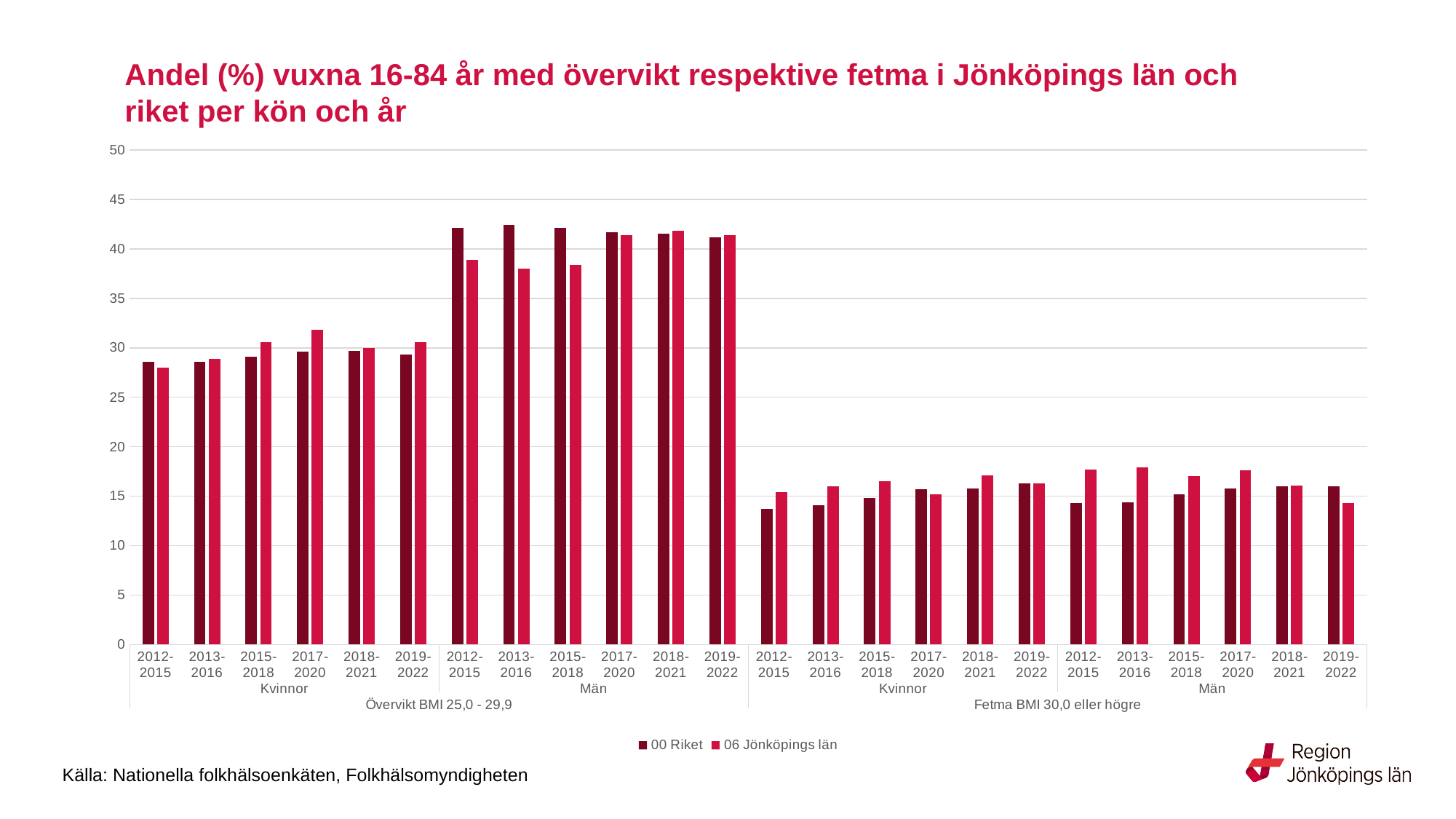
In the Fetma BMI 30,0 eller högre group, which period has the lowest value for Män in the 06 Jönköpings län series? 2019-2022 In the Fetma BMI 30,0 eller högre group, is the value for Män 2013-2016 for 06 Jönköpings län greater or less than 15? greater In the Övervikt BMI 25,0 - 29,9 group, which period has the highest value for Kvinnor in the 06 Jönköpings län series? 2017-2020 In the Övervikt BMI 25,0 - 29,9 group, is the value for Kvinnor 2017-2020 for 06 Jönköpings län greater or less than 30? greater In the Fetma BMI 30,0 eller högre group, is the value for Kvinnor 2012-2015 for 00 Riket greater or less than 15? less How many time periods are shown for each sex within each BMI group? 6 What kind of chart is shown on the slide? bar chart How many series does the legend list? 2 In the Övervikt BMI 25,0 - 29,9 group for Män 2013-2016, which series has the larger value, 00 Riket or 06 Jönköpings län? 00 Riket What are the two series named in the legend? 00 Riket and 06 Jönköpings län In the Fetma BMI 30,0 eller högre group for Män 2012-2015, which series has the larger value, 00 Riket or 06 Jönköpings län? 06 Jönköpings län